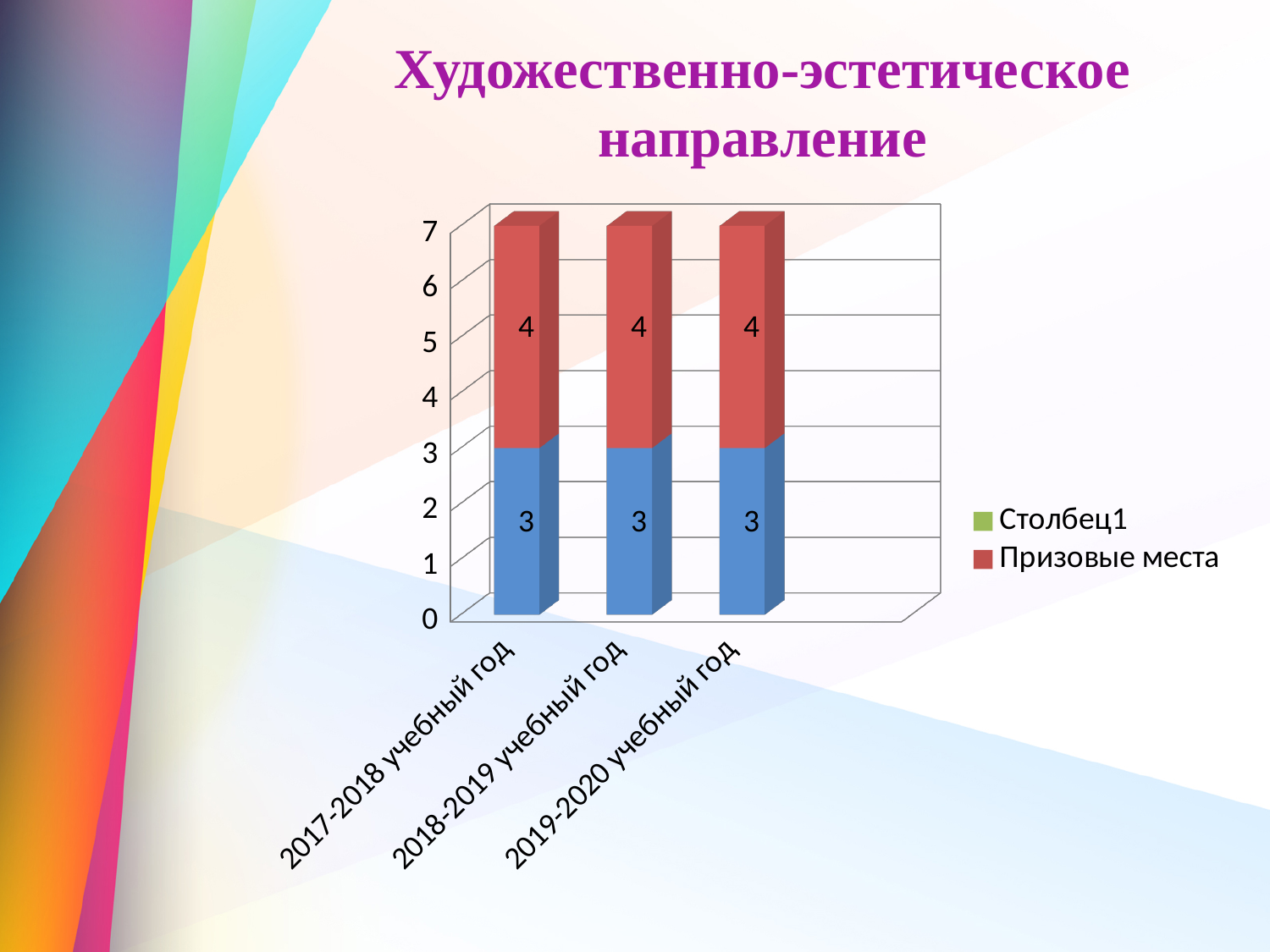
Is the total of the stacked bar for 2019-2020 учебный год greater or less than 5? greater What is the title of the slide above the chart? Художественно-эстетическое направление What is the value of the blue segment for 2019-2020 учебный год? 3 Do the values for Призовые места rise, fall or stay the same across the school years? Stay the same What kind of chart is shown on the slide? Bar chart What is the total of the stacked bar for 2018-2019 учебный год? 7 In 2018-2019 учебный год, which segment is larger: the red (Призовые места) or the blue one? Red (Призовые места) How many categories (school years) are shown on the x axis? 3 How many series does the legend list? 2 What are the two entries listed in the chart legend? Столбец1 and Призовые места For 2017-2018 учебный год, what is the difference between the red segment and the blue segment? 1 What is the value of Призовые места for 2017-2018 учебный год? 4